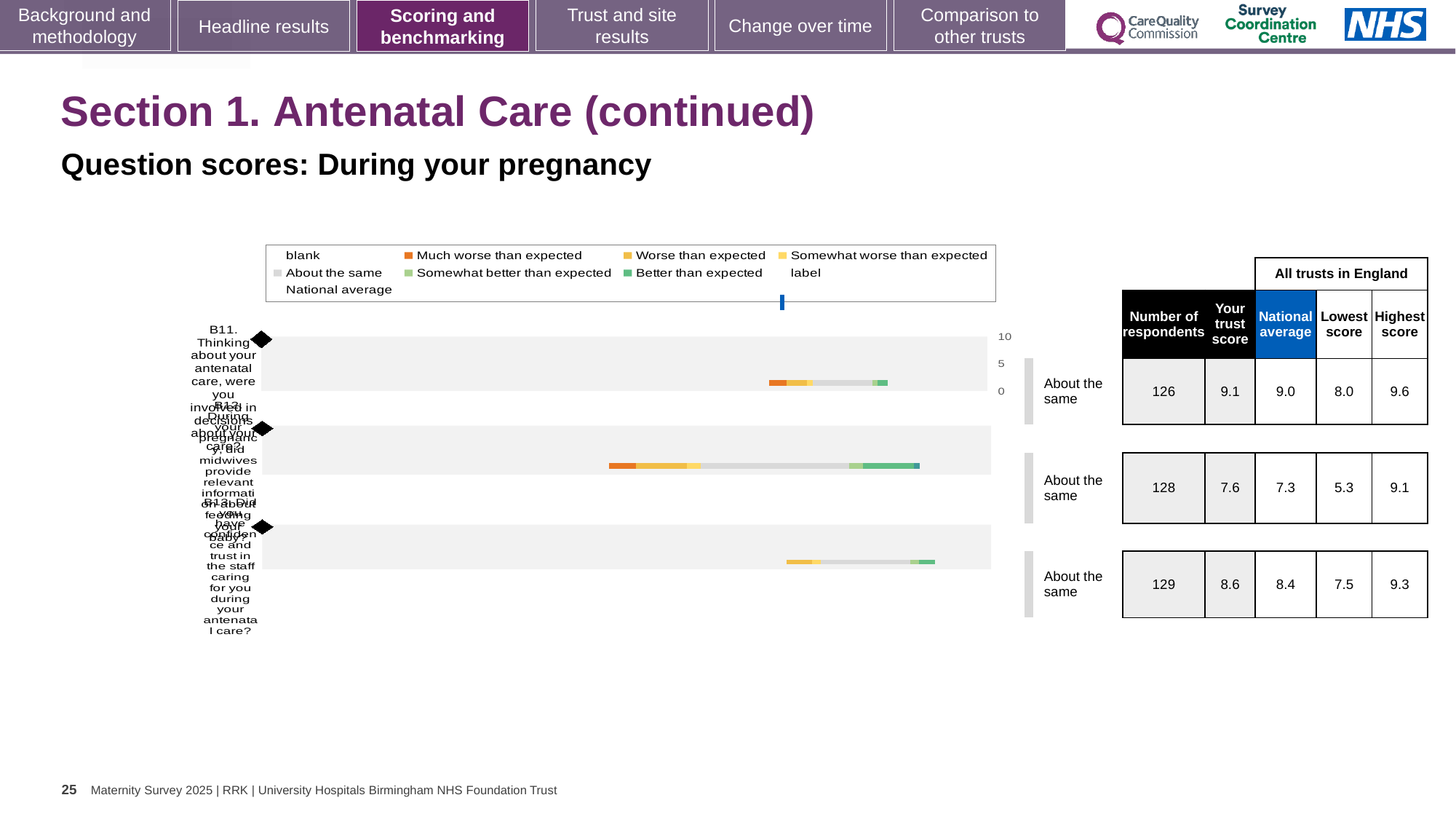
In the table beside the chart, what is the Number of respondents for the third row (B13)? 129 In the table beside the chart, what is the National average for the second row (B12)? 7.3 For the second row (B12), what is the difference between the Highest score and the Lowest score? 3.8 How many question bars are plotted in the chart? 3 What kind of chart is shown on the slide? bar chart Which row in the table has the lowest 'Lowest score' value? B12 (5.3) How many entries does the chart legend list? 9 For the third row (B13), which is larger: 'Your trust score' or the National average? Your trust score (8.6) What is the highest value shown on the chart's numeric axis? 10 What benchmark category is shown next to the first bar (B11)? About the same In the table beside the chart, what is the 'Your trust score' for the first row (B11)? 9.1 Which row in the table has the highest 'Your trust score'? B11 (9.1)